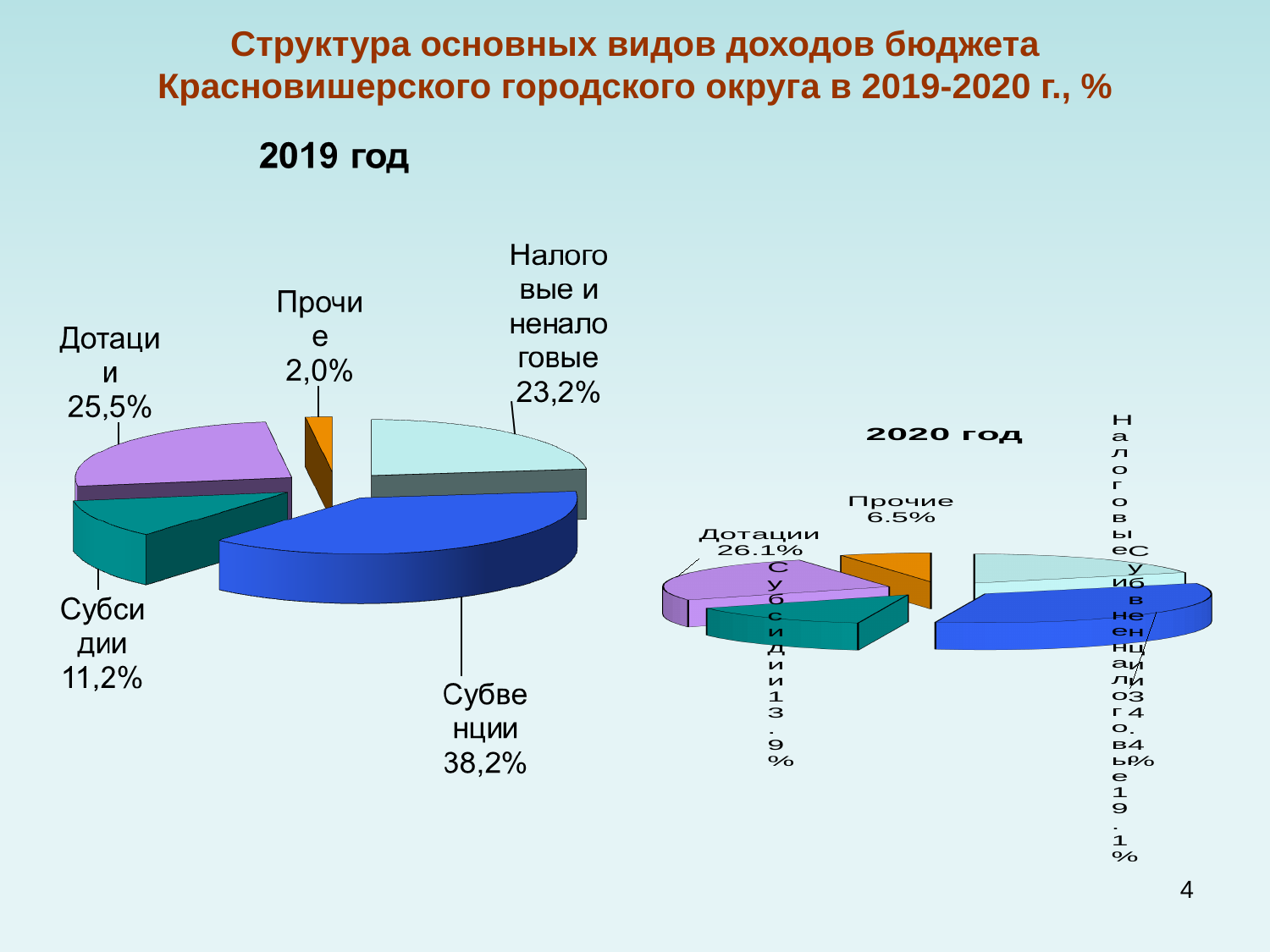
On the 2020 год chart, what share do Дотации have? 26.1% On the 2020 год chart, what share do Прочие have? 6.5% On the 2019 год chart, which category has the smallest share? Прочие On the 2019 год chart, which category has the largest share? Субвенции On the 2019 год chart, what share do Субвенции have? 38,2% On the 2019 год chart, what share do Налоговые и неналоговые доходы have? 23,2% How many categories are shown on the 2019 год chart? 5 On the 2019 год chart, what share do Дотации have? 25,5% On the 2019 год chart, what share do Субсидии have? 11,2% What type of chart is used for the 2019 год data? Pie chart On the 2019 год chart, what is the difference in percentage points between Субвенции and Дотации? 12,7 On the 2019 год chart, which is larger: Дотации or Налоговые и неналоговые? Дотации